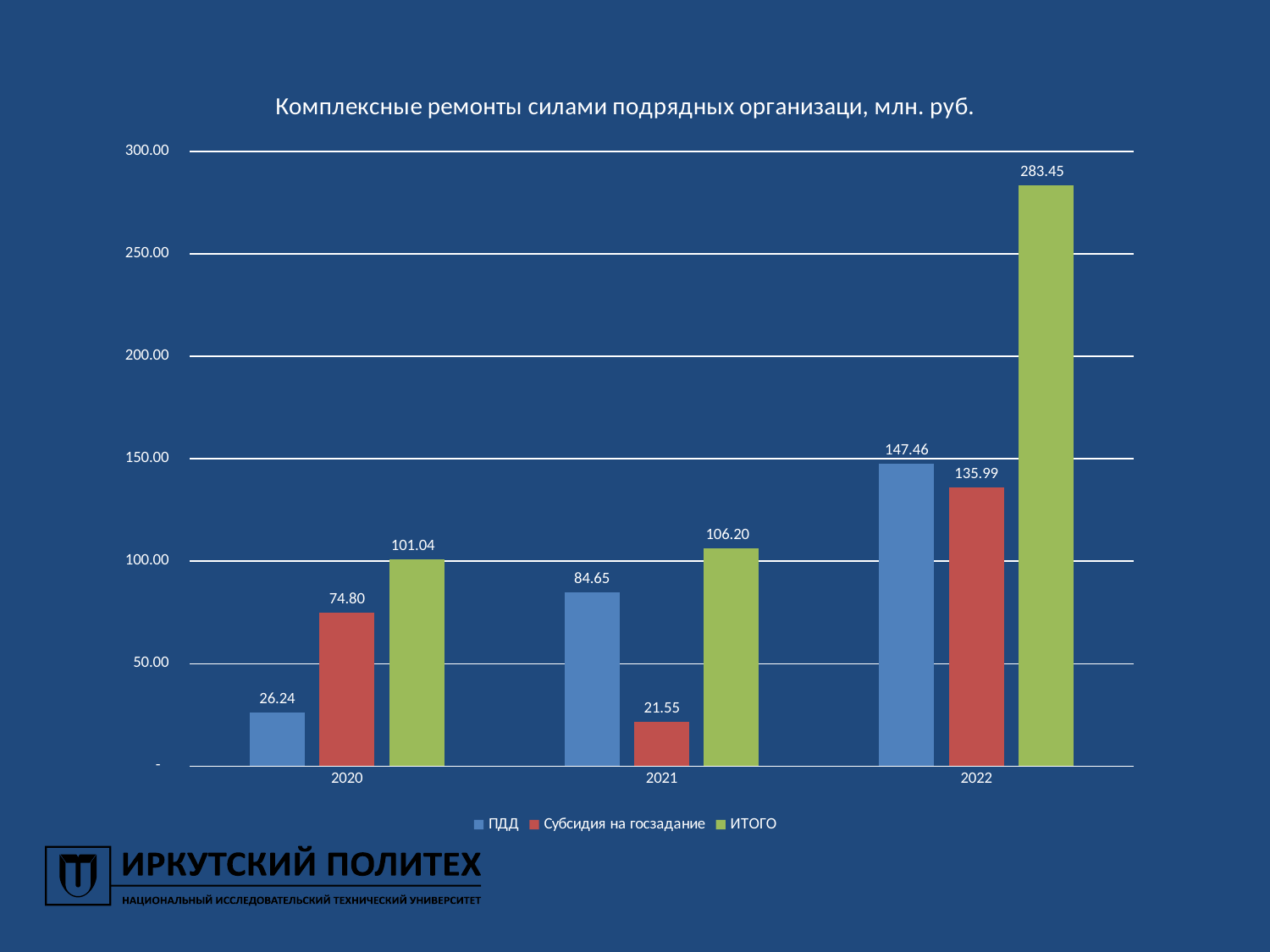
How many years are shown on the x axis? 3 What colour are the ИТОГО bars? Green What is the value for Субсидия на госзадание in 2022? 135.99 How many series does the legend list? 3 Which is larger in 2020: ПДД or Субсидия на госзадание? Субсидия на госзадание What is the ИТОГО value for 2021? 106.20 What kind of chart is shown on the slide? Bar chart In which year is the ИТОГО value highest? 2022 Does the ИТОГО value rise or fall from 2020 to 2022? Rise What is the difference between the ПДД values for 2022 and 2021? 62.81 In which year is the Субсидия на госзадание value lowest? 2021 What is the value for ПДД in 2020? 26.24